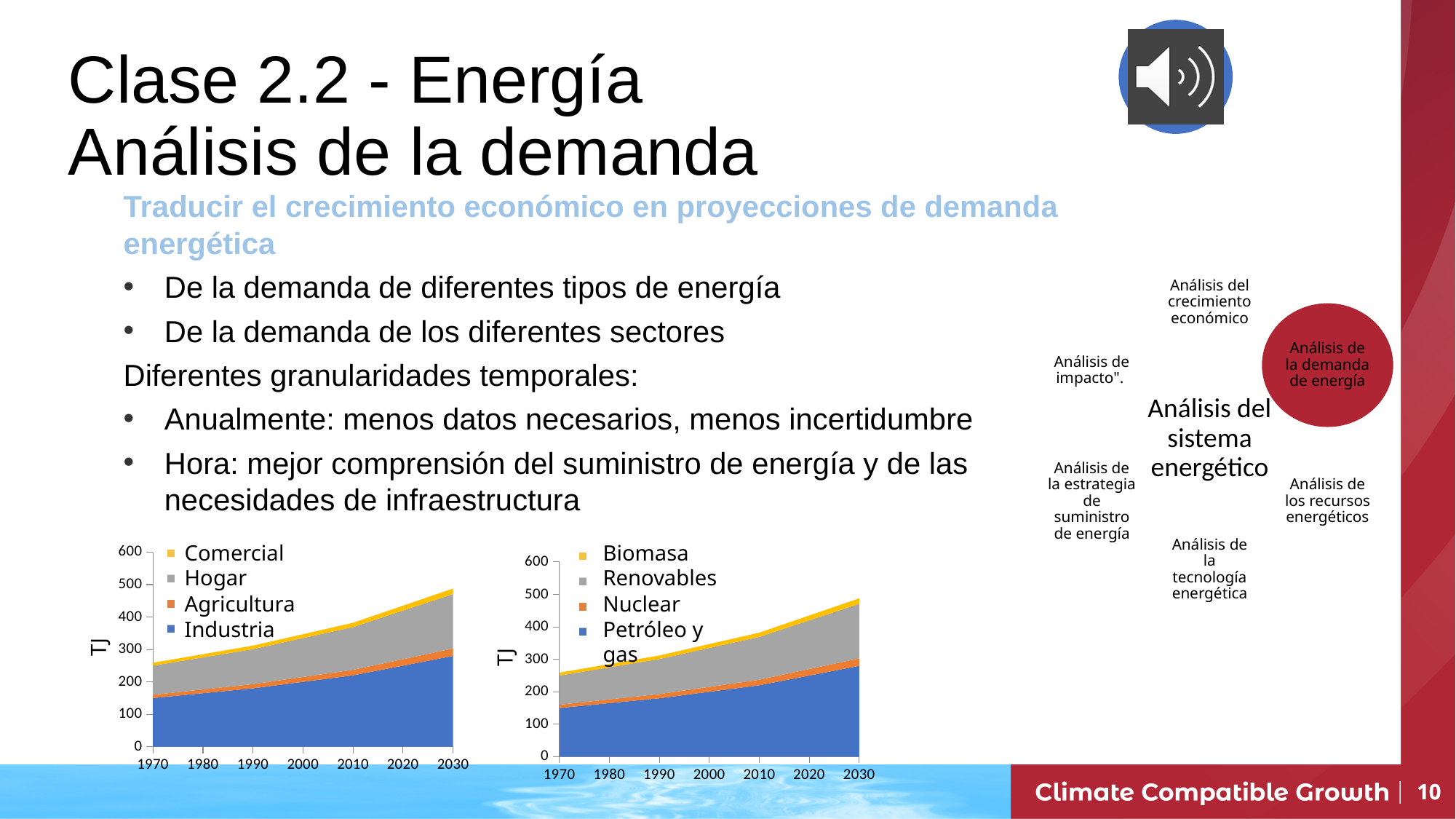
How many series does the legend of the left chart list? 4 In the right chart, does the Petróleo y gas area rise or fall from 1970 to 2030? Rise In the left chart, is the total stacked value in 2030 greater or less than 400? greater How many series does the legend of the right chart list? 4 What is the y-axis label of the left chart? TJ In the right chart, is the value for Petróleo y gas in 2030 greater or less than 200? greater In the left chart, which series is larger in 2030, Industria or Agricultura? Industria In the left chart, is the total stacked value in 1970 greater or less than 300? less In the right chart, which series is shown at the bottom of the stack in blue? Petróleo y gas How many year labels are shown on the x axis of the right chart? 7 In the left chart, does the total stacked value rise or fall from 1970 to 2030? Rise What kind of chart is the left chart (with the Comercial, Hogar, Agricultura, Industria legend)? Stacked area chart